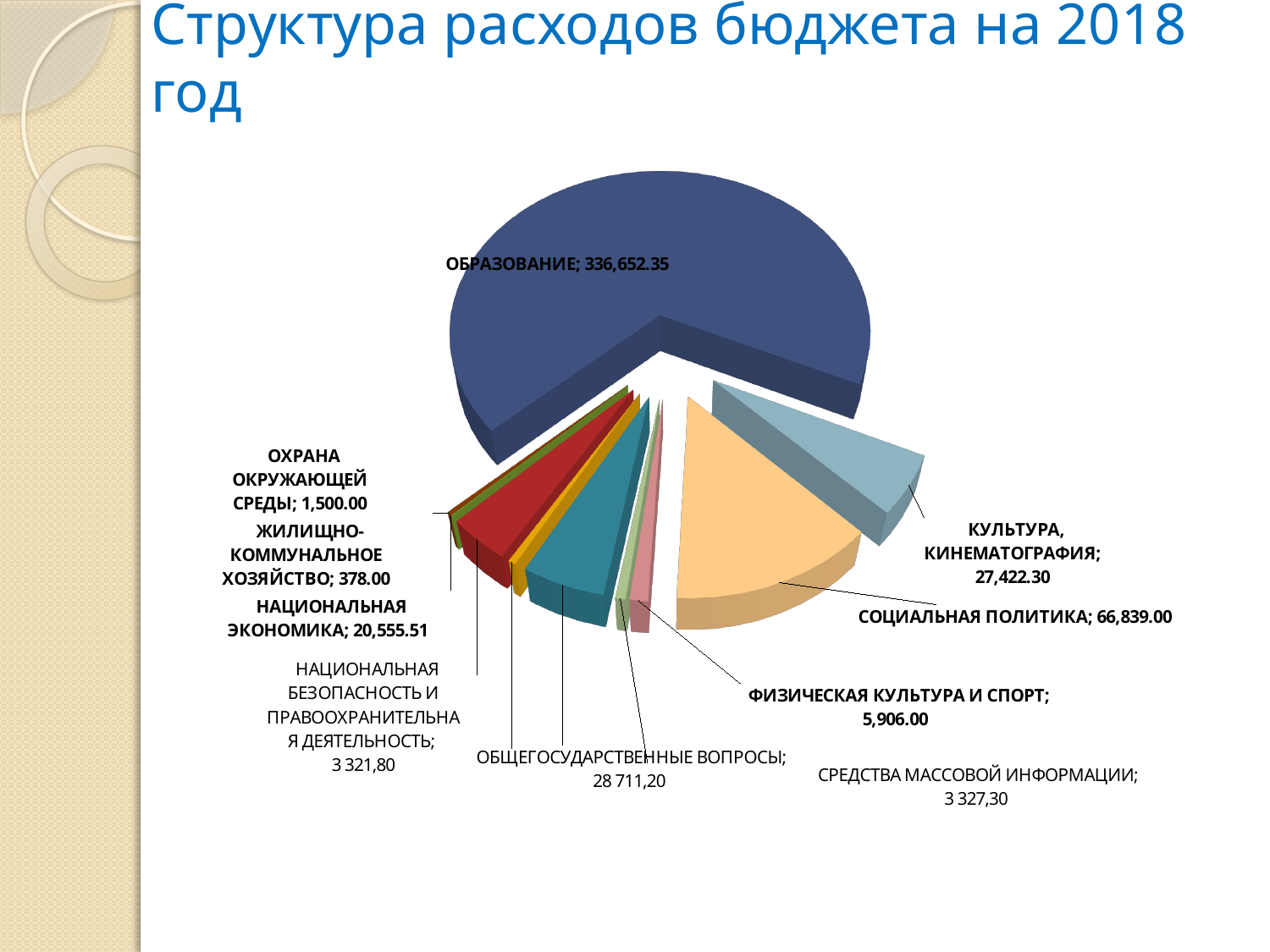
Which is larger: the value for НАЦИОНАЛЬНАЯ ЭКОНОМИКА or the value for ФИЗИЧЕСКАЯ КУЛЬТУРА И СПОРТ? НАЦИОНАЛЬНАЯ ЭКОНОМИКА What is the difference between the values for СОЦИАЛЬНАЯ ПОЛИТИКА and КУЛЬТУРА, КИНЕМАТОГРАФИЯ? 39,416.70 What is the value for ОБЩЕГОСУДАРСТВЕННЫЕ ВОПРОСЫ? 28 711,20 What is the value for ОБРАЗОВАНИЕ in the pie chart? 336,652.35 Which category has the largest slice of the pie? ОБРАЗОВАНИЕ What kind of chart is shown on the slide? Pie chart What is the value for КУЛЬТУРА, КИНЕМАТОГРАФИЯ? 27,422.30 What is the value for ЖИЛИЩНО-КОММУНАЛЬНОЕ ХОЗЯЙСТВО? 378.00 How many categories are shown in the pie chart? 10 What is the title of the slide? Структура расходов бюджета на 2018 год Which category has the smallest value in the pie chart? ЖИЛИЩНО-КОММУНАЛЬНОЕ ХОЗЯЙСТВО What is the value for СОЦИАЛЬНАЯ ПОЛИТИКА? 66,839.00